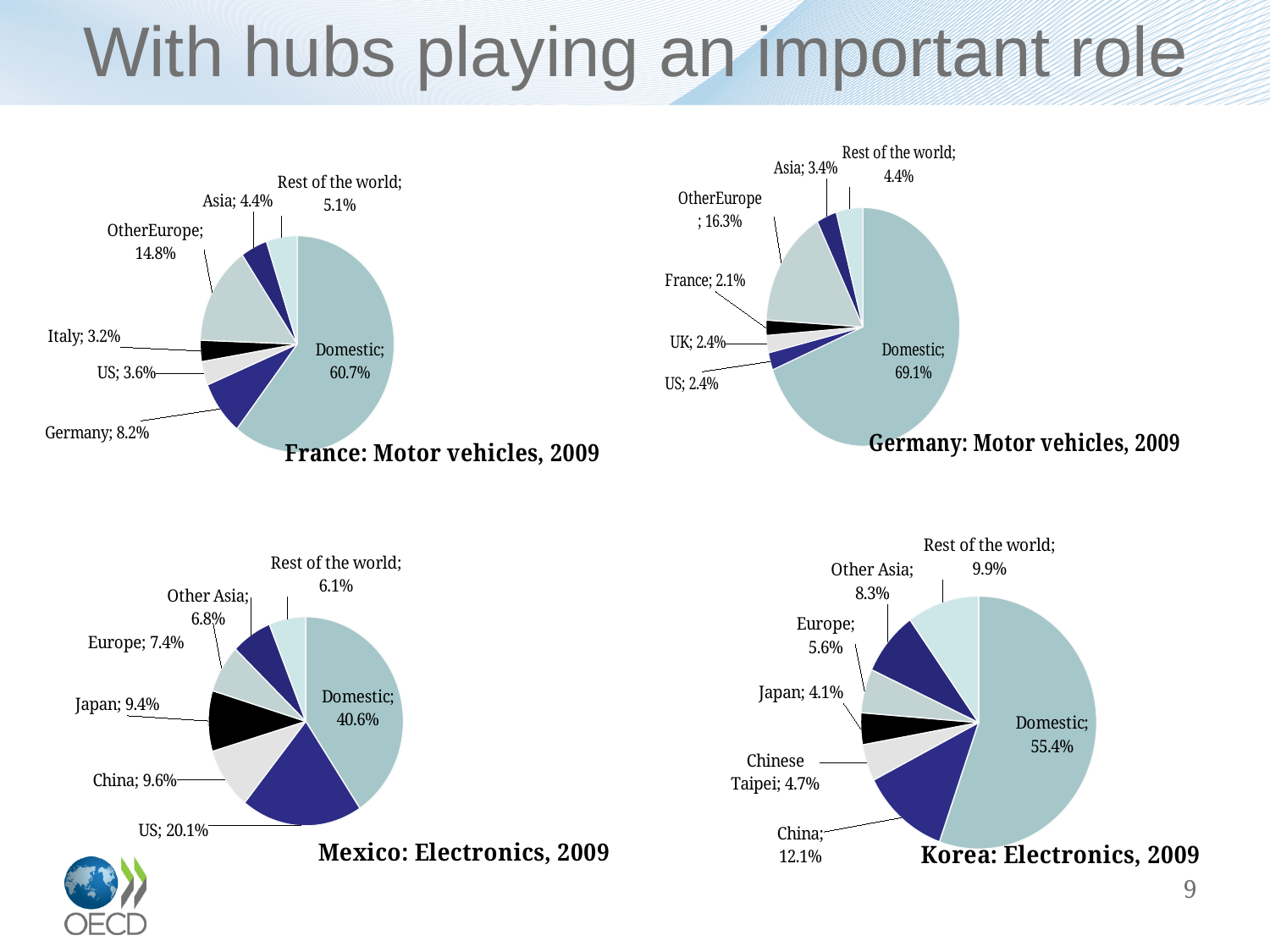
In the 'Mexico: Electronics, 2009' chart, what is the difference between the China and Japan shares? 0.2% In the 'France: Motor vehicles, 2009' chart, what is the difference between the Germany and US shares? 4.6% In the 'France: Motor vehicles, 2009' chart, what share is Domestic? 60.7% In the 'Germany: Motor vehicles, 2009' chart, what share is Asia? 3.4% In the 'Mexico: Electronics, 2009' chart, what share is US? 20.1% How many pie charts are shown on the slide? 4 In the 'France: Motor vehicles, 2009' chart, what share is OtherEurope? 14.8% In the 'Korea: Electronics, 2009' chart, which is larger, Other Asia or Rest of the world? Rest of the world In the 'Korea: Electronics, 2009' chart, what share is China? 12.1% In the 'Germany: Motor vehicles, 2009' chart, which slice is the smallest? France What type of chart is 'Korea: Electronics, 2009'? Pie chart How many slices does the 'Mexico: Electronics, 2009' chart have? 7